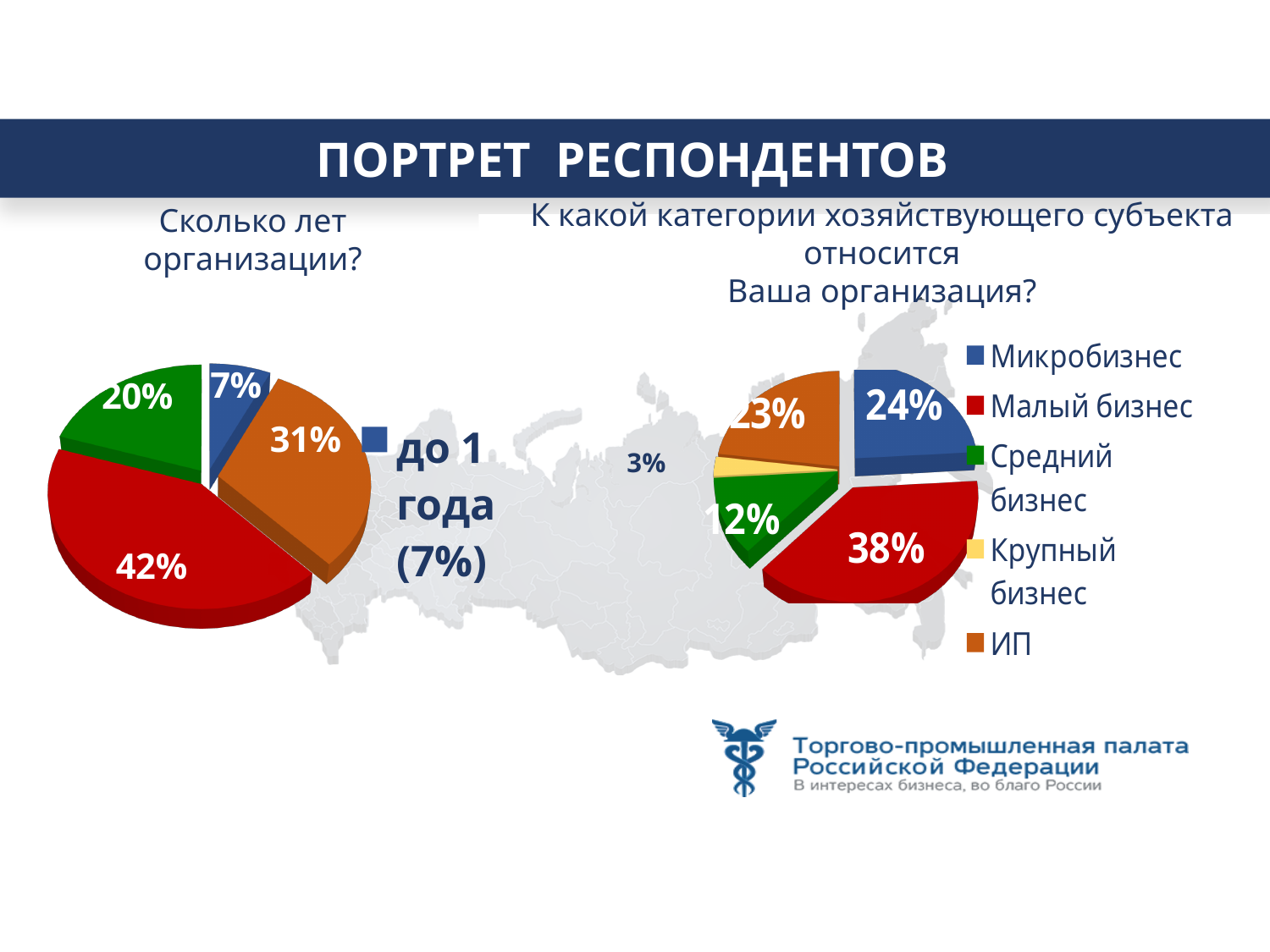
What type of chart is the left chart (Сколько лет организации?)? Pie chart On the right chart, what share is shown for Крупный бизнес? 3% On the right chart, which category has the largest share? Малый бизнес On the right chart, how many categories does the legend list? 5 On the right chart (К какой категории хозяйствующего субъекта относится Ваша организация?), what share is shown for Малый бизнес? 38% On the right chart, which category has the smallest share? Крупный бизнес On the right chart, what share is shown for Средний бизнес? 12% On the right chart, what share is shown for ИП? 23% On the right chart, what is the difference between the shares of Малый бизнес and Микробизнес? 14 percentage points On the left chart (Сколько лет организации?), how many slices does the pie have? 4 On the right chart, what share is shown for Микробизнес? 24% On the left chart (Сколько лет организации?), what share is shown for до 1 года? 7%